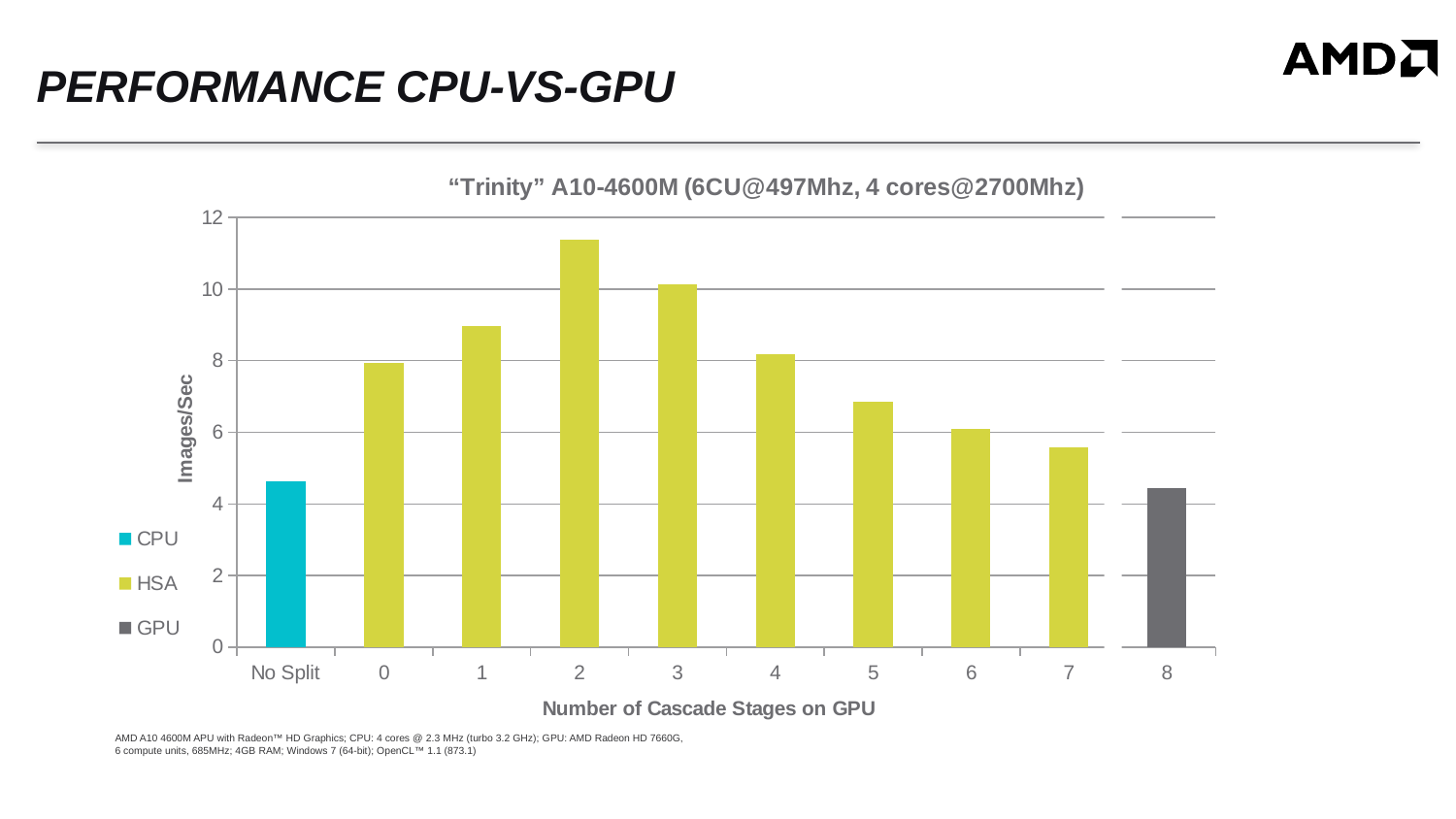
Is the value for 7 cascade stages greater or less than 6? less Do the values rise or fall from 2 cascade stages to 7 cascade stages? fall Is the value for No Split greater or less than 4? greater Which is larger, the value for 1 cascade stage or for 5 cascade stages? 1 Which category has the highest Images/Sec value? 2 Is the value for 2 cascade stages greater or less than 10? greater What kind of chart is shown on the slide? bar chart What is the label of the y axis? Images/Sec Which series does the No Split bar belong to, according to the legend? CPU How many series does the legend list? 3 How many categories are shown on the x axis? 10